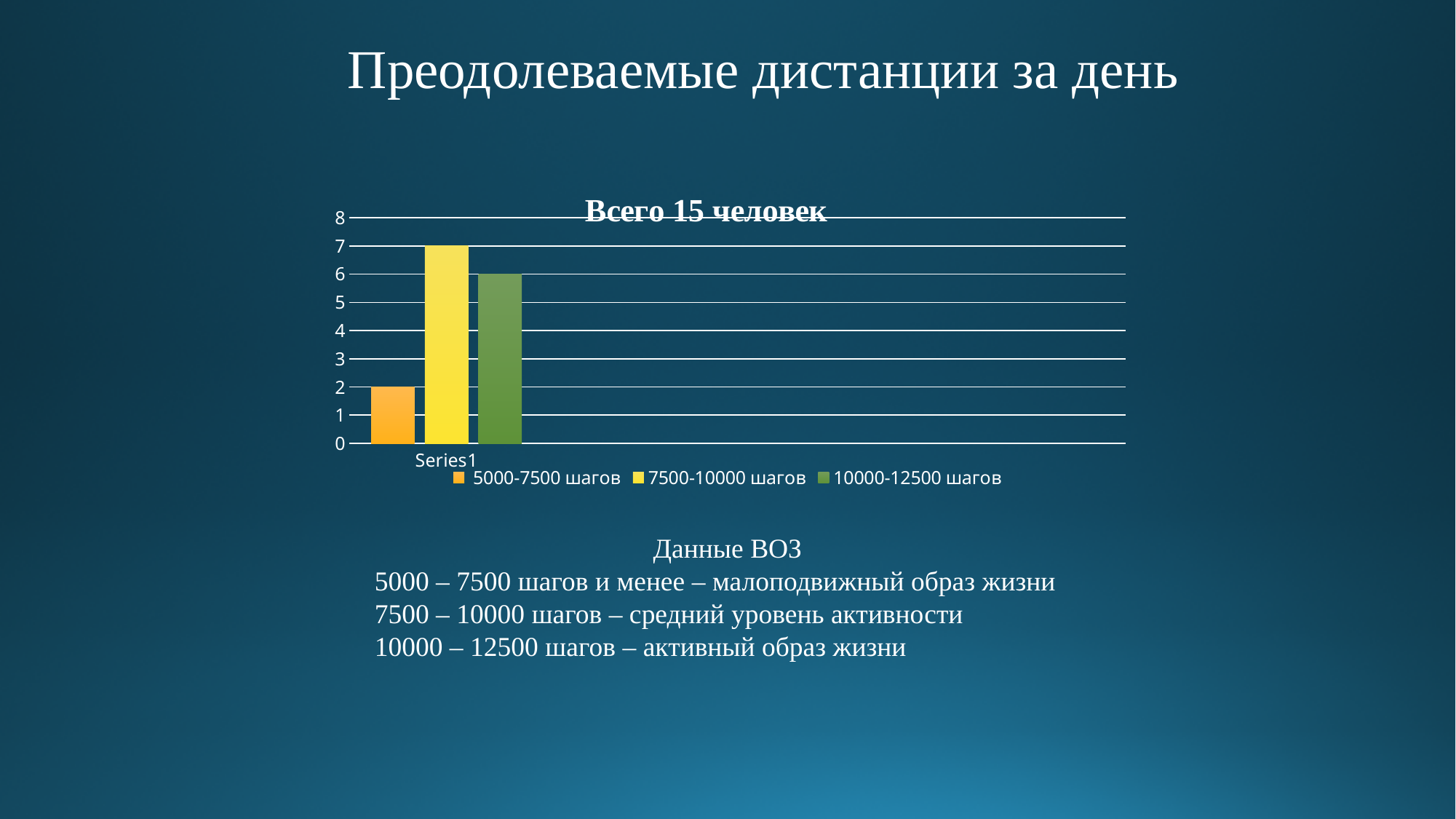
Which series has the highest value? 7500-10000 шагов What type of chart is shown on the slide? bar chart Is the value for 7500-10000 шагов greater or less than 5? greater What is the title of the chart? Всего 15 человек Which series has the lowest value? 5000-7500 шагов What is the difference between the values for 7500-10000 шагов and 5000-7500 шагов? 5 What is the value for the series 7500-10000 шагов? 7 What colour is the bar for 10000-12500 шагов? green How many series does the chart legend list? 3 What is the value for the series 10000-12500 шагов? 6 Which is larger: the value for 10000-12500 шагов or the value for 5000-7500 шагов? 10000-12500 шагов What is the value for the series 5000-7500 шагов? 2